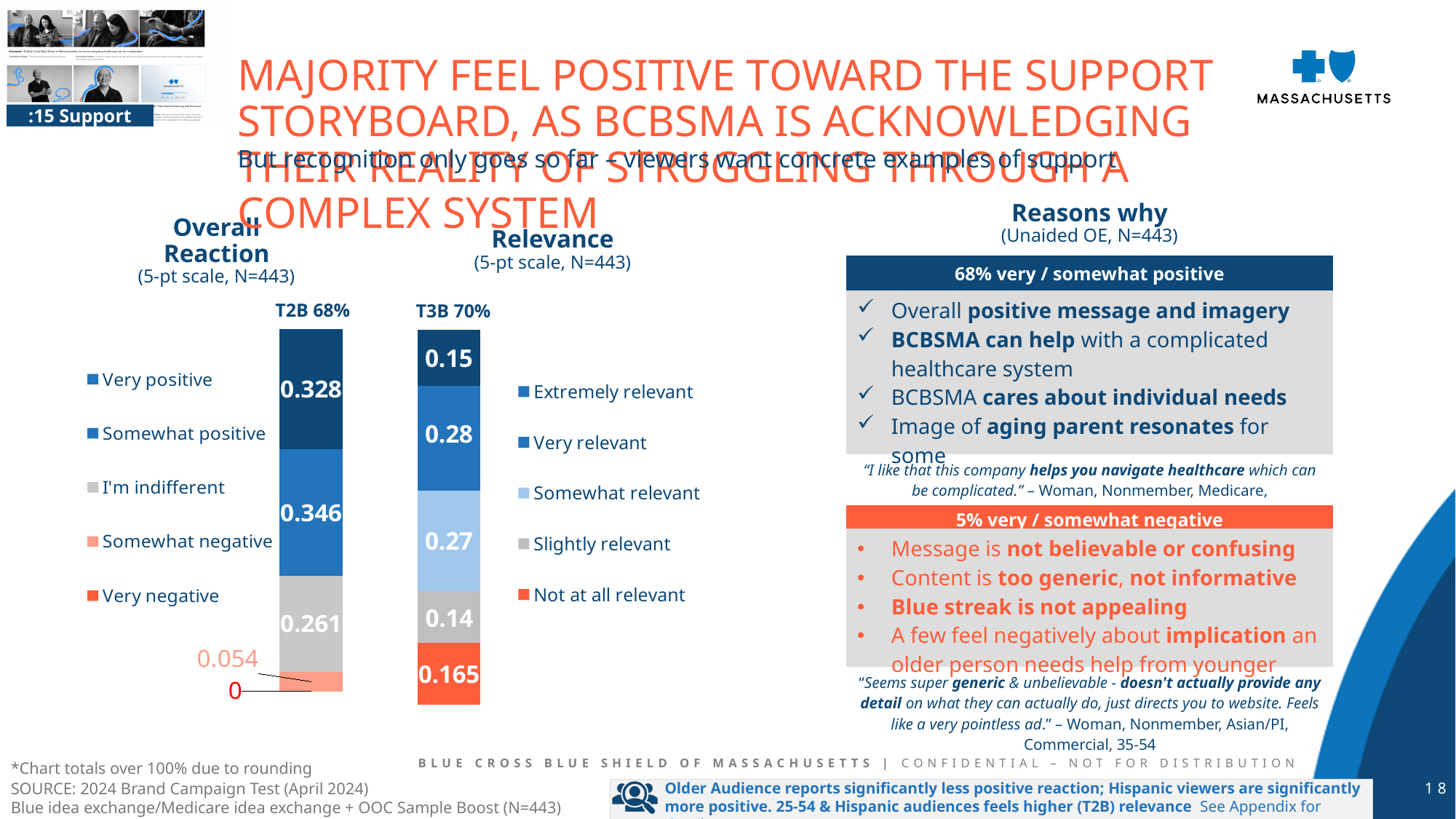
In the Overall Reaction chart, what is the difference between Somewhat positive and Very positive? 0.018 In the Overall Reaction chart, which category has the lowest value? Very negative In the Relevance chart, what is the value for Not at all relevant? 0.165 In the Relevance chart, which category has the highest value? Very relevant In the Overall Reaction chart, what is the value for Very positive? 0.328 In the Relevance chart, what is the value for Somewhat relevant? 0.27 In the Relevance chart, which is larger, Extremely relevant or Not at all relevant? Not at all relevant How many entries does the legend of the Relevance chart list? 5 In the Overall Reaction chart, which category has the highest value? Somewhat positive In the Overall Reaction chart, what is the value for I'm indifferent? 0.261 What type of chart is the Overall Reaction chart? Stacked bar chart In the Overall Reaction chart, what is the value for Somewhat negative? 0.054